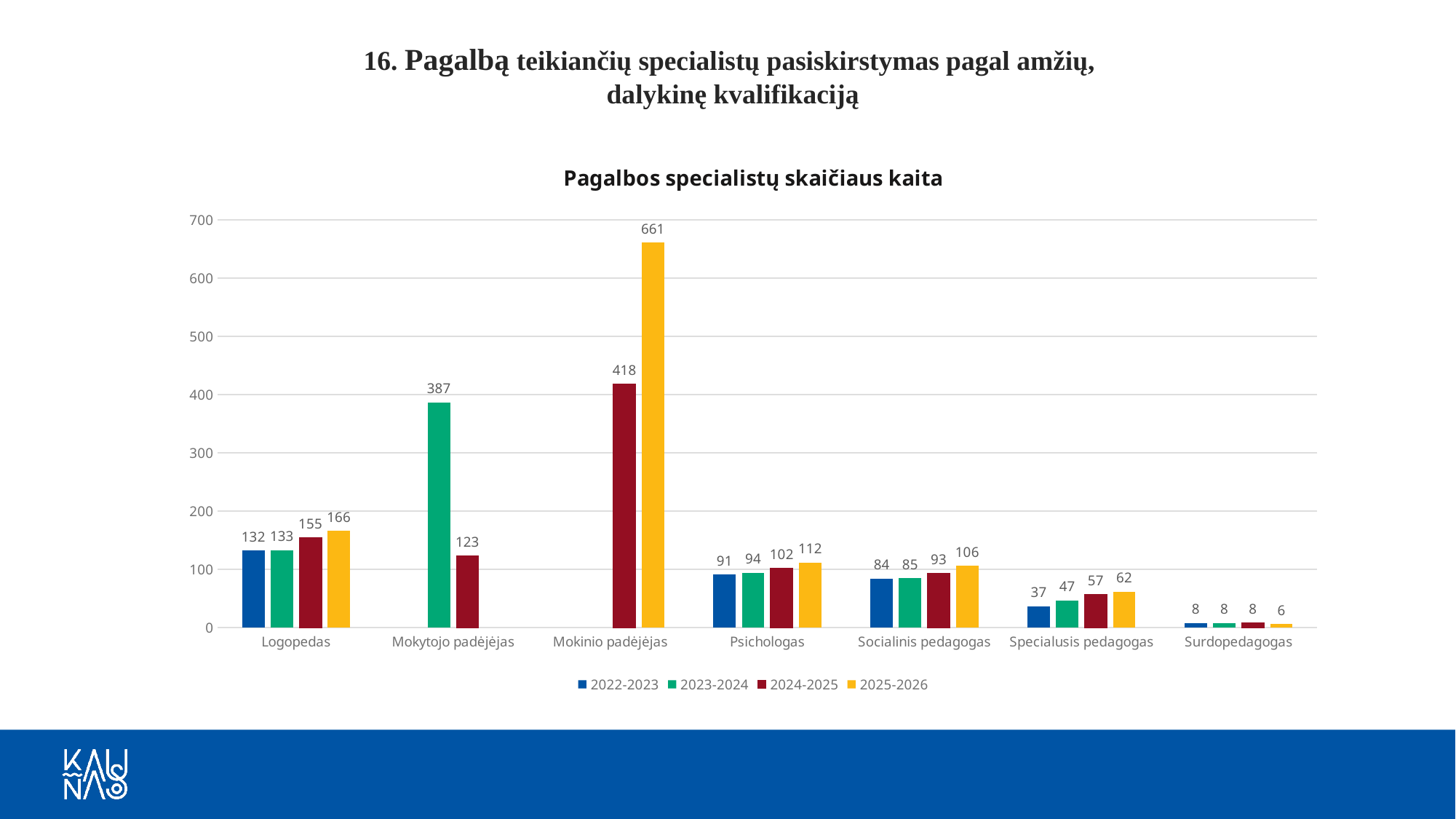
Which category has the highest value in 2023-2024? Mokytojo padėjėjas What is the title of the chart? Pagalbos specialistų skaičiaus kaita What is the value for Logopedas in 2022-2023? 132 Which is larger: the 2025-2026 value for Psichologas or the 2025-2026 value for Socialinis pedagogas? Psichologas How many series does the legend list? 4 What is the difference between the 2025-2026 and 2024-2025 values for Mokinio padėjėjas? 243 What is the value for Mokinio padėjėjas in 2025-2026? 661 How many categories are shown on the x axis? 7 Which category has the lowest value in 2025-2026? Surdopedagogas What kind of chart is shown on the slide? bar chart What is the value for Specialusis pedagogas in 2024-2025? 57 Do the values for Specialusis pedagogas rise or fall from 2022-2023 to 2025-2026? rise